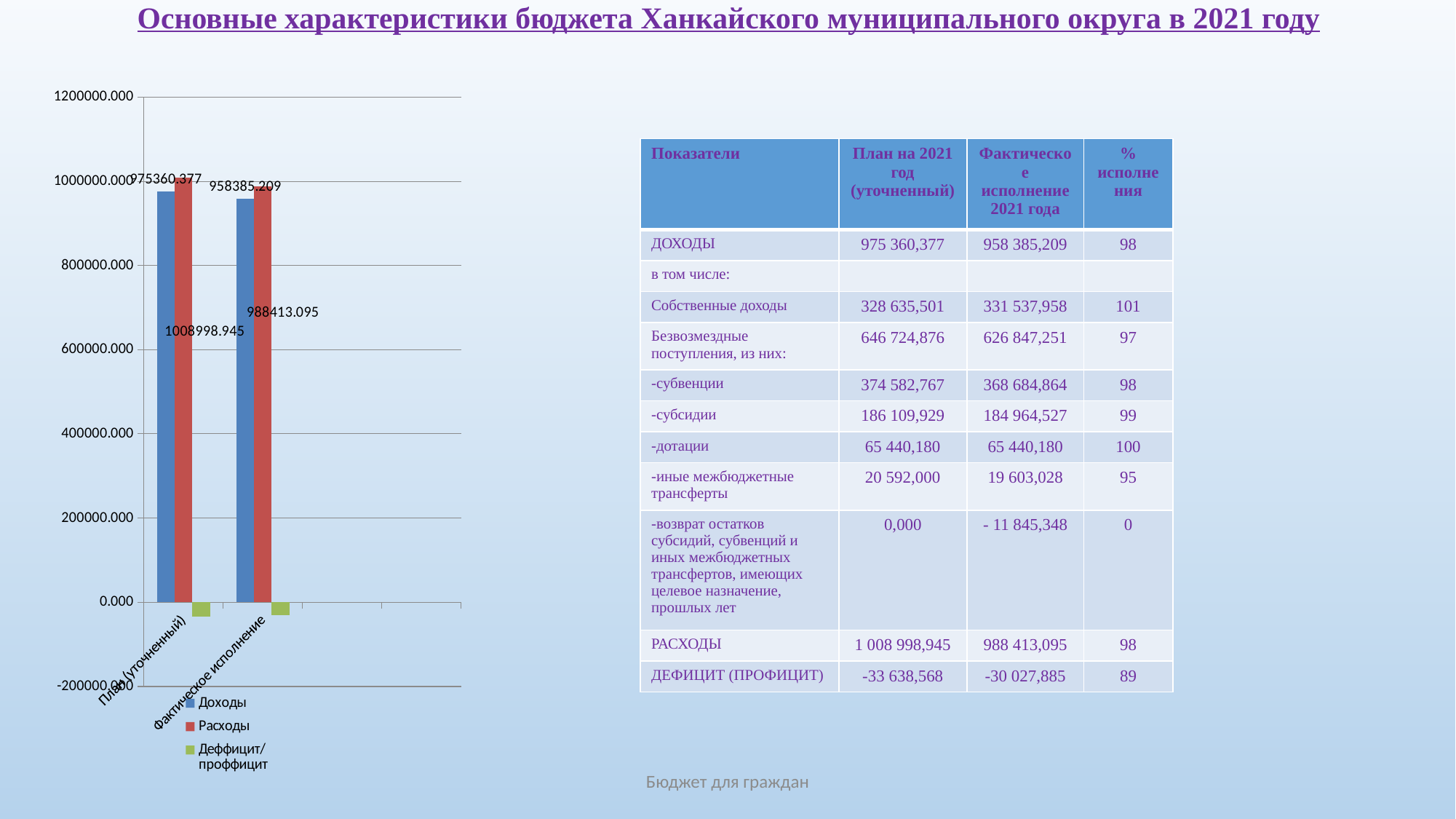
What is the value of Расходы for План (уточненный)? 1008998.945 For План (уточненный), which is larger: Доходы or Расходы? Расходы What is the difference between Расходы and Доходы for План (уточненный)? 33638.568 What type of chart is shown on the slide? bar chart What is the value of Доходы for План (уточненный)? 975360.377 What is the value of Доходы for Фактическое исполнение? 958385.209 Which bar is the tallest in the chart? Расходы for План (уточненный) What is the value of Расходы for Фактическое исполнение? 988413.095 How many categories are shown on the x axis of the chart? 2 What is the difference between Доходы for План (уточненный) and Доходы for Фактическое исполнение? 16975.168 How many series does the chart legend list? 3 Is the value of Деффицит/проффицит for План (уточненный) greater or less than 0.000? less